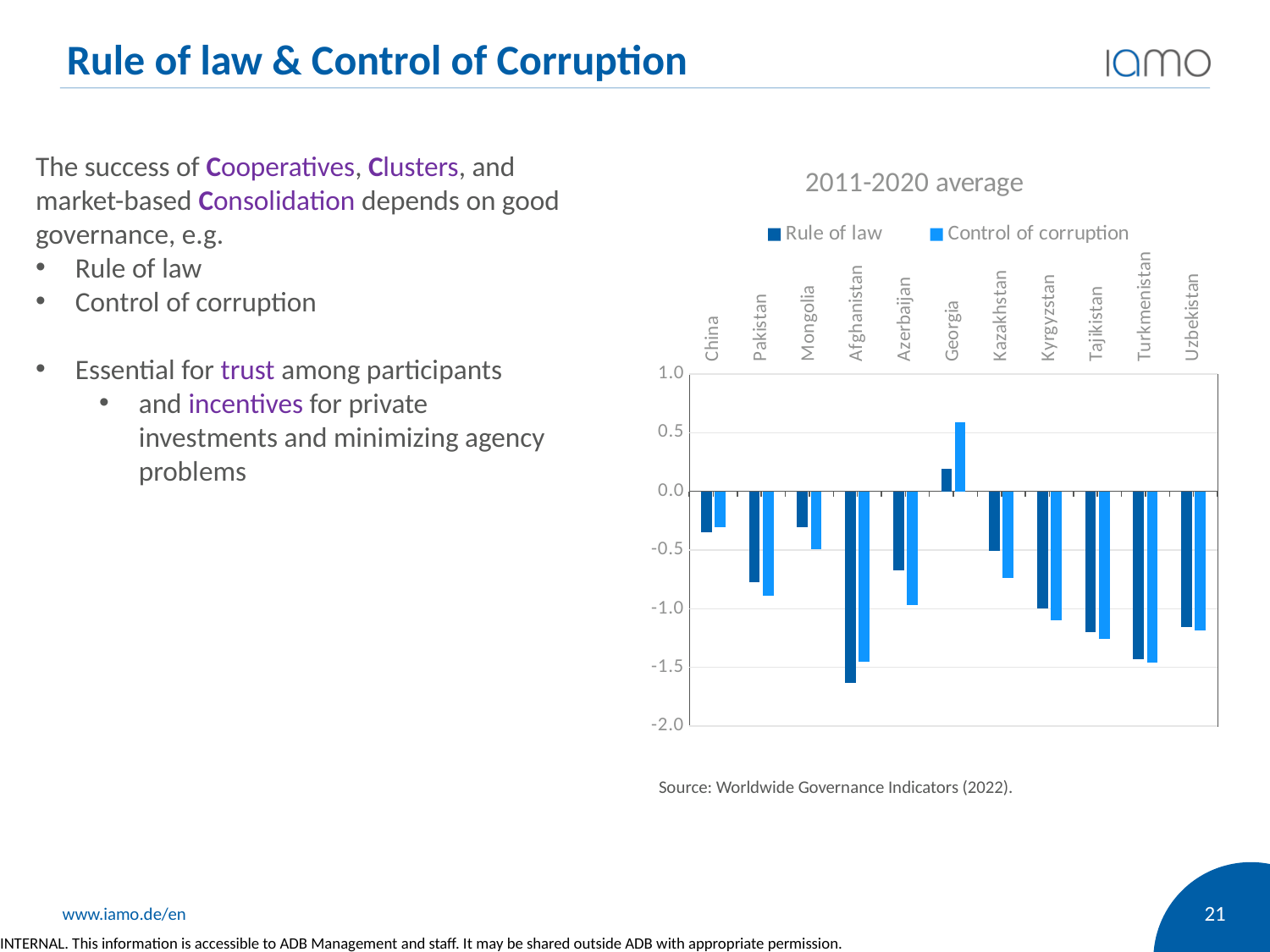
How many series does the chart legend list? 2 What is the title of the chart? 2011-2020 average What kind of chart is shown on the slide? bar chart Which is larger for Azerbaijan, the Rule of law value or the Control of corruption value? Rule of law Is the Rule of law value for Afghanistan greater or less than -1.5? less Which country is the only one with positive values for both Rule of law and Control of corruption? Georgia Is the Control of corruption value for Georgia greater or less than 0.5? greater Which two series are listed in the chart legend? Rule of law and Control of corruption Which country has the lowest Rule of law value? Afghanistan How many countries are shown on the x axis of the chart? 11 Is the Control of corruption value for Kazakhstan greater or less than -0.5? less Which country has the highest Control of corruption value? Georgia